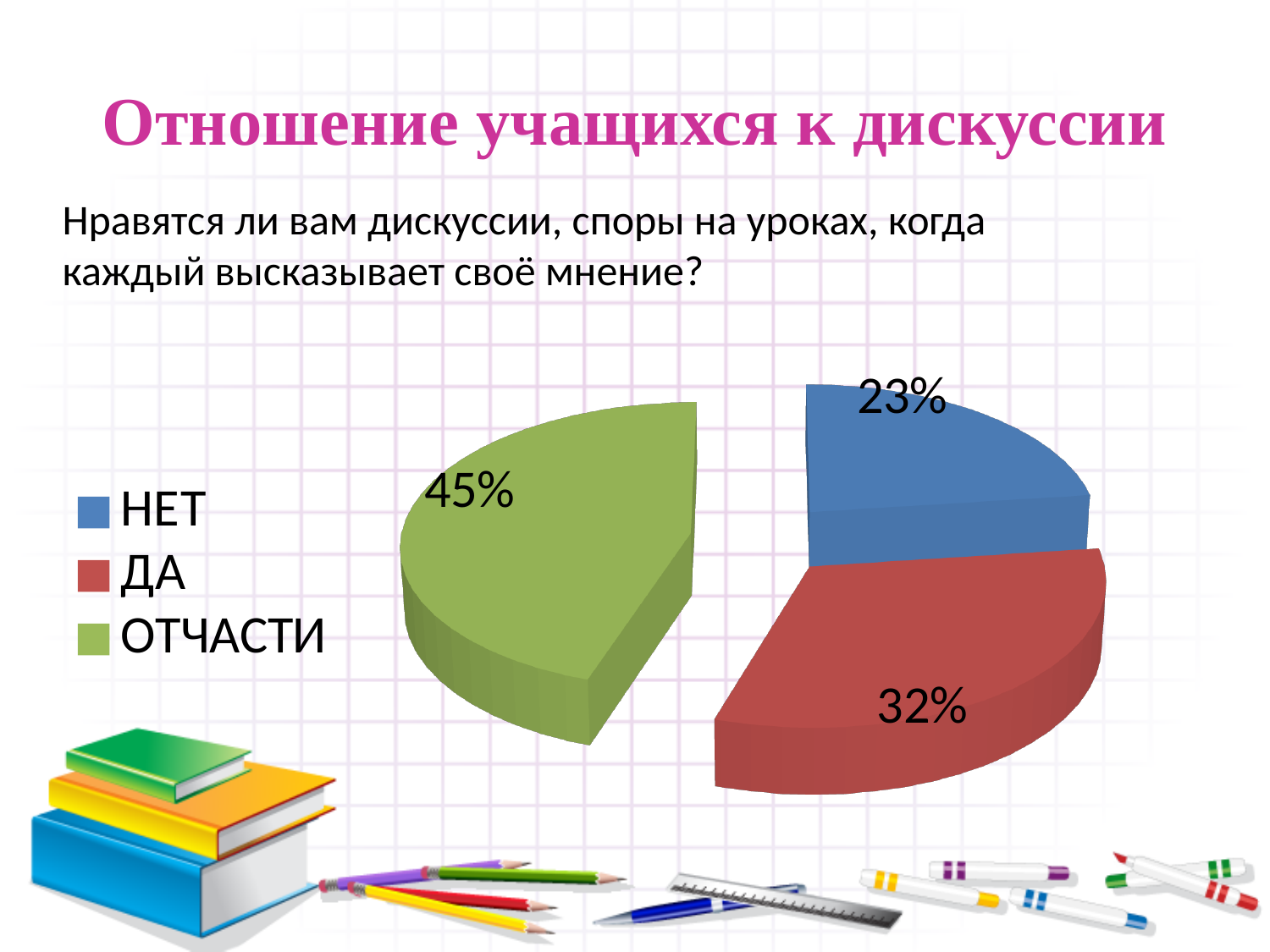
What share of the pie does НЕТ have? 23% What share of the pie does ДА have? 32% Which is larger, the share for ДА or the share for НЕТ? ДА What share of the pie does ОТЧАСТИ have? 45% What is the title of the slide containing the chart? Отношение учащихся к дискуссии What is the difference in percentage points between ДА and НЕТ? 9 What is the difference in percentage points between ОТЧАСТИ and НЕТ? 22 How many categories does the pie chart have? 3 Which category has the largest slice of the pie? ОТЧАСТИ What colour is the slice for ОТЧАСТИ? green What kind of chart is shown on the slide? pie chart Which category has the smallest slice of the pie? НЕТ